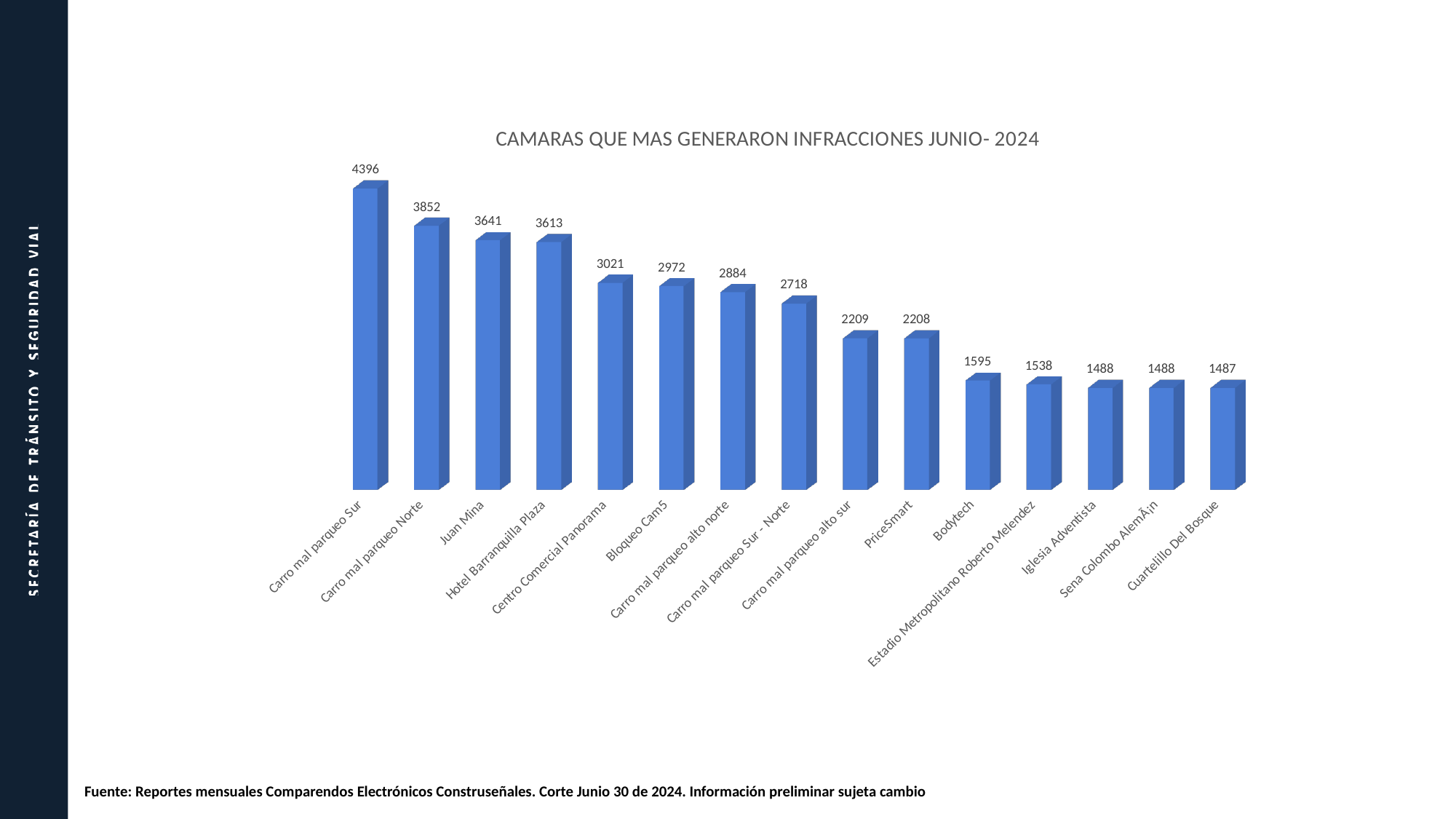
How many cameras (categories) are shown in the chart? 15 What is the value for Centro Comercial Panorama? 3021 What is the difference between Bloqueo Cam5 and Carro mal parqueo alto norte? 88 What is the difference between Carro mal parqueo Sur and Carro mal parqueo Norte? 544 What is the title of the chart? CAMARAS QUE MAS GENERARON INFRACCIONES JUNIO- 2024 How many infractions did Juan Mina generate? 3641 Which camera generated the most infractions? Carro mal parqueo Sur Do the values rise or fall from left to right along the x axis? Fall What is the value for PriceSmart? 2208 What is the value for Bodytech? 1595 What type of chart is shown on the slide? Bar chart Which is larger, Hotel Barranquilla Plaza or Centro Comercial Panorama? Hotel Barranquilla Plaza